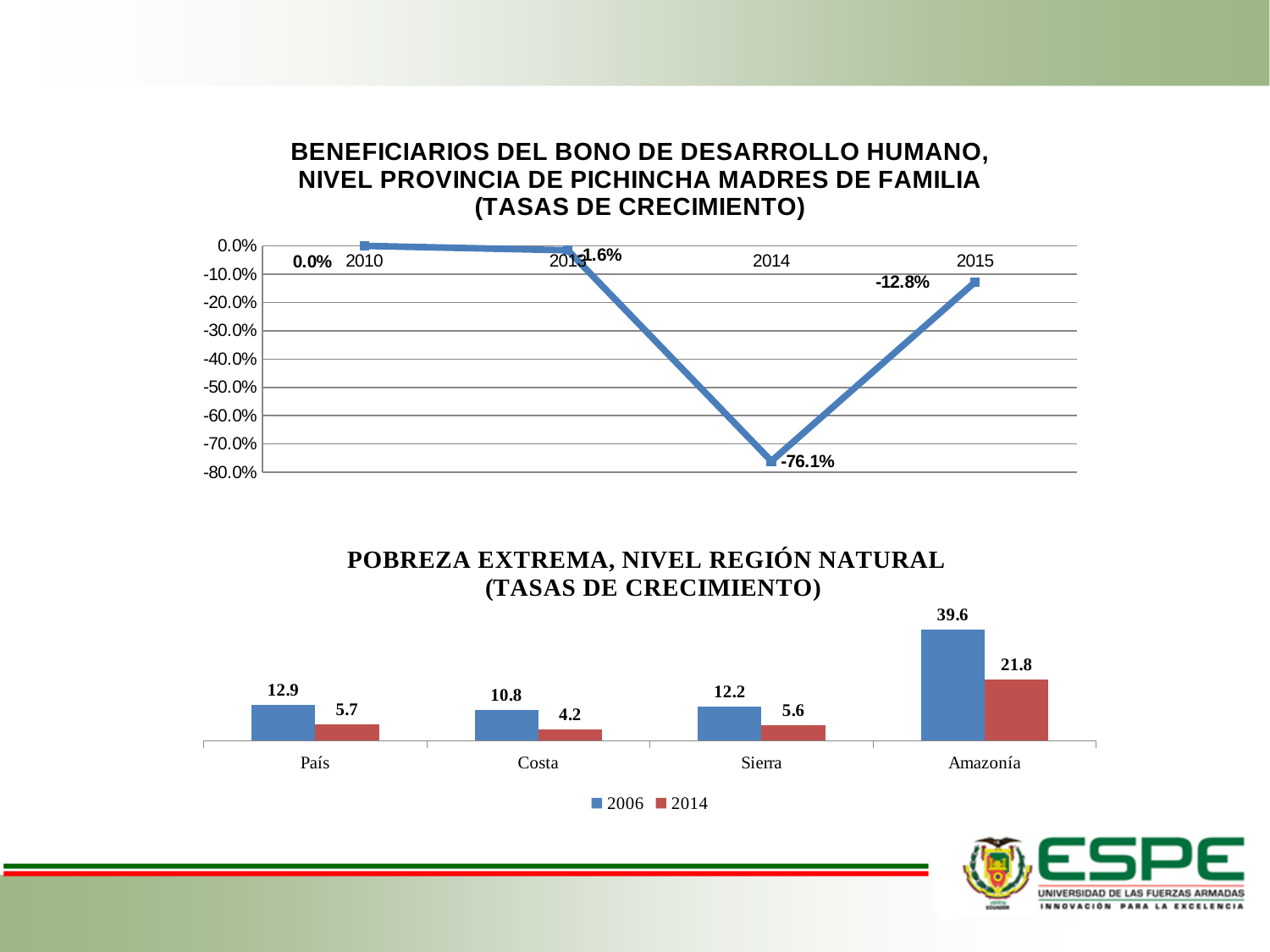
In the bottom chart (POBREZA EXTREMA, NIVEL REGIÓN NATURAL), which region has the highest 2014 value? Amazonía In the bottom chart (POBREZA EXTREMA, NIVEL REGIÓN NATURAL), what is the difference between the 2006 and 2014 values for País? 7.2 What kind of chart is the bottom chart (POBREZA EXTREMA, NIVEL REGIÓN NATURAL)? Bar chart In the bottom chart (POBREZA EXTREMA, NIVEL REGIÓN NATURAL), which is larger: the 2006 value for Sierra or the 2006 value for Costa? Sierra In the top chart (BENEFICIARIOS DEL BONO DE DESARROLLO HUMANO), how many data points are plotted? 4 In the bottom chart (POBREZA EXTREMA, NIVEL REGIÓN NATURAL), what is the 2006 value for Amazonía? 39.6 In the top chart (BENEFICIARIOS DEL BONO DE DESARROLLO HUMANO), what is the value for 2015? -12.8% How many series does the legend of the bottom chart (POBREZA EXTREMA, NIVEL REGIÓN NATURAL) list? 2 In the top chart (BENEFICIARIOS DEL BONO DE DESARROLLO HUMANO), what is the value for 2014? -76.1% In the bottom chart (POBREZA EXTREMA, NIVEL REGIÓN NATURAL), what is the 2014 value for Costa? 4.2 In the top chart (BENEFICIARIOS DEL BONO DE DESARROLLO HUMANO), which year has the lowest value? 2014 What kind of chart is the top chart (BENEFICIARIOS DEL BONO DE DESARROLLO HUMANO)? Line chart